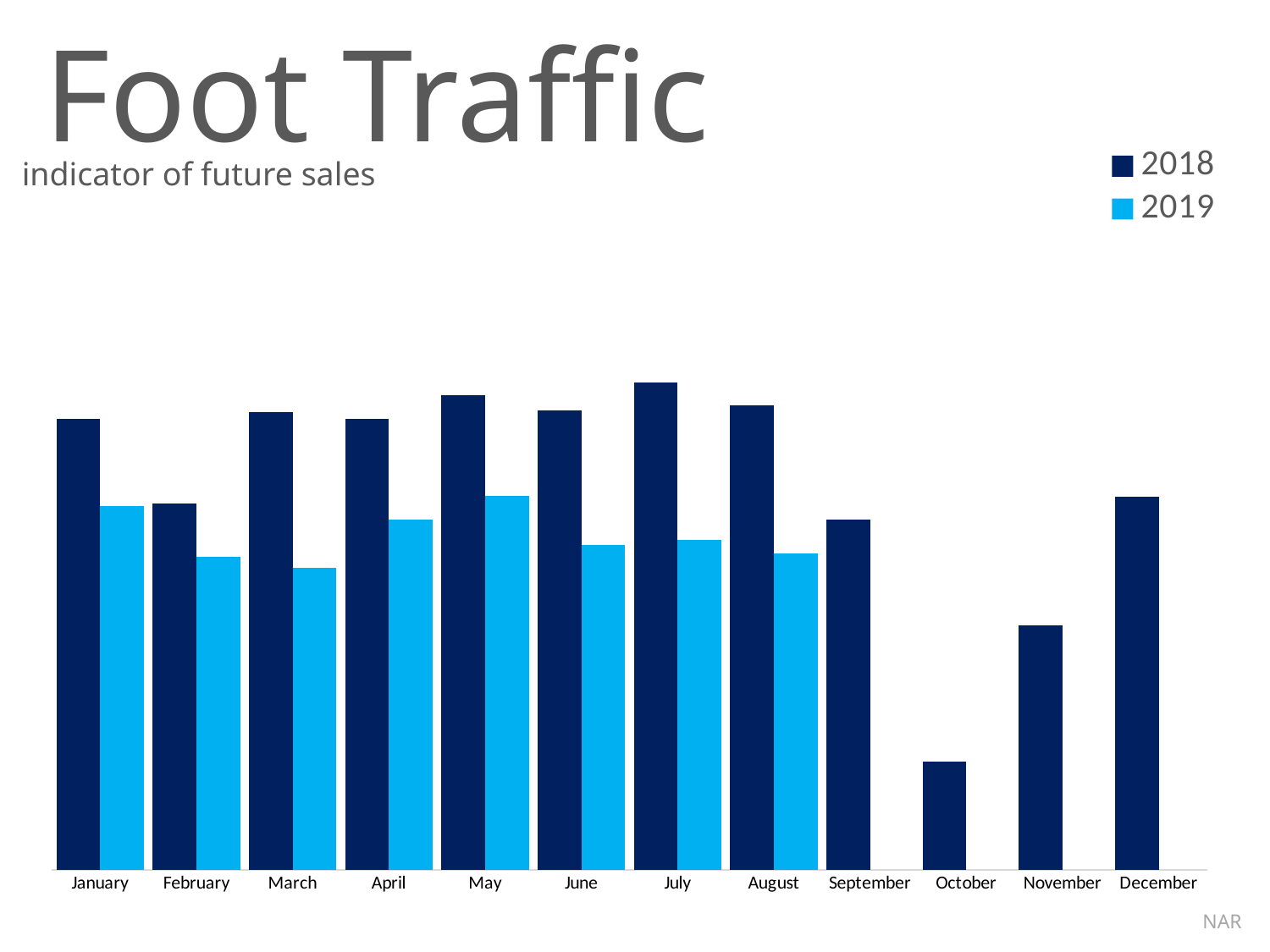
Which is larger, the 2018 value for November or the 2018 value for December? December Which month has the highest 2018 value? July Which month has the lowest 2018 value? October How many months are shown along the x axis? 12 Which month has the highest 2019 value? May For how many months is a 2019 bar plotted? 8 Does the 2018 value rise or fall from September to October? fall Which month has the lowest 2019 value? March In January, which year has the larger value, 2018 or 2019? 2018 What kind of chart is shown on the slide? bar chart How many series does the legend list? 2 What is the title of the chart? Foot Traffic